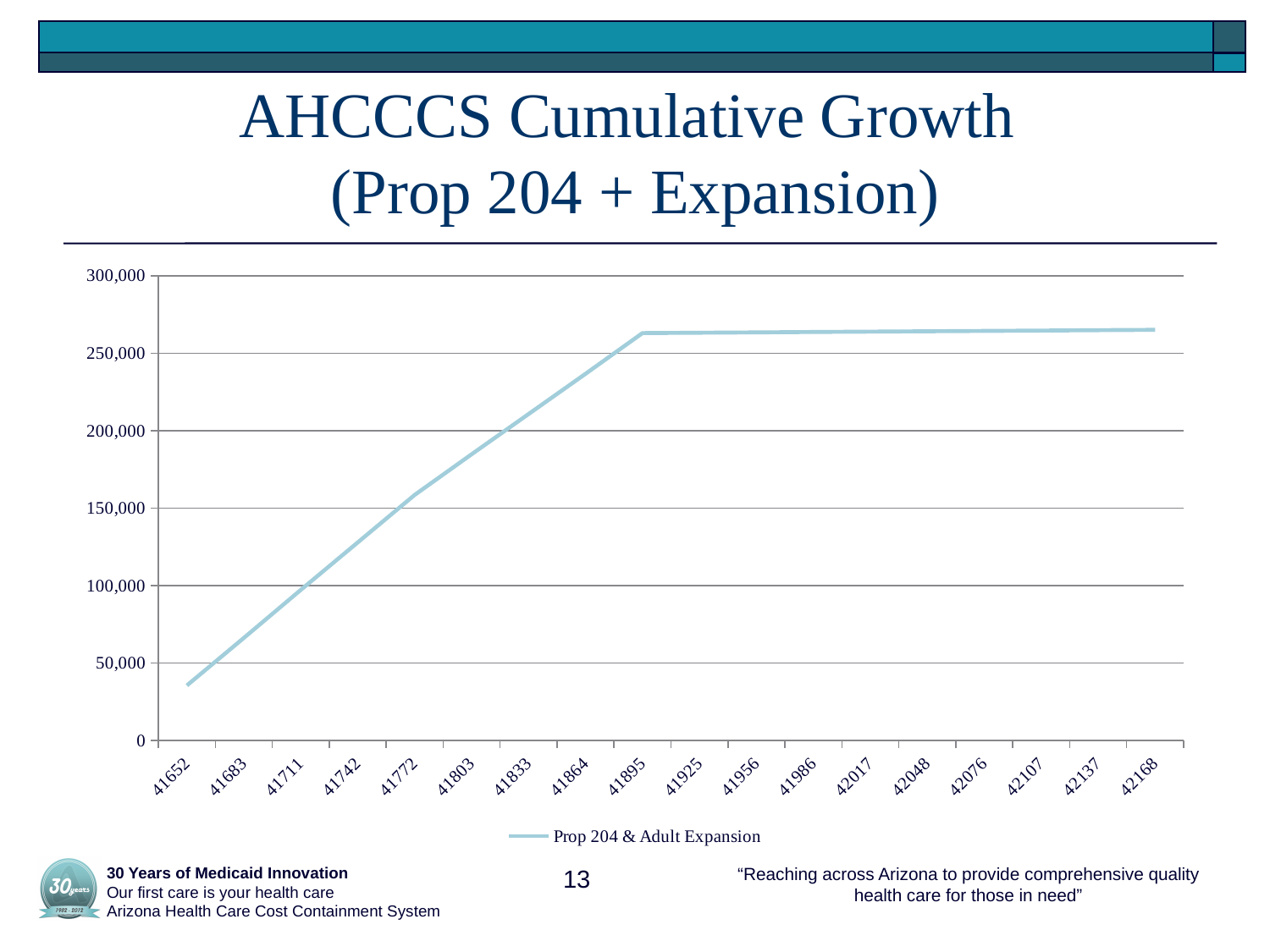
How many points are labelled along the x axis? 18 What kind of chart is shown on the slide? line chart How does the line change from 41652 to 41895? it rises What is the name of the series shown in the legend? Prop 204 & Adult Expansion Is the value at 42168 greater or less than 300,000? less How many series does the legend list? 1 Which is larger, the value at 41683 or the value at 41803? 41803 Which x-axis category has the lowest value? 41652 Is the value at 41652 greater or less than 50,000? less Is the value at 41742 greater or less than 100,000? greater